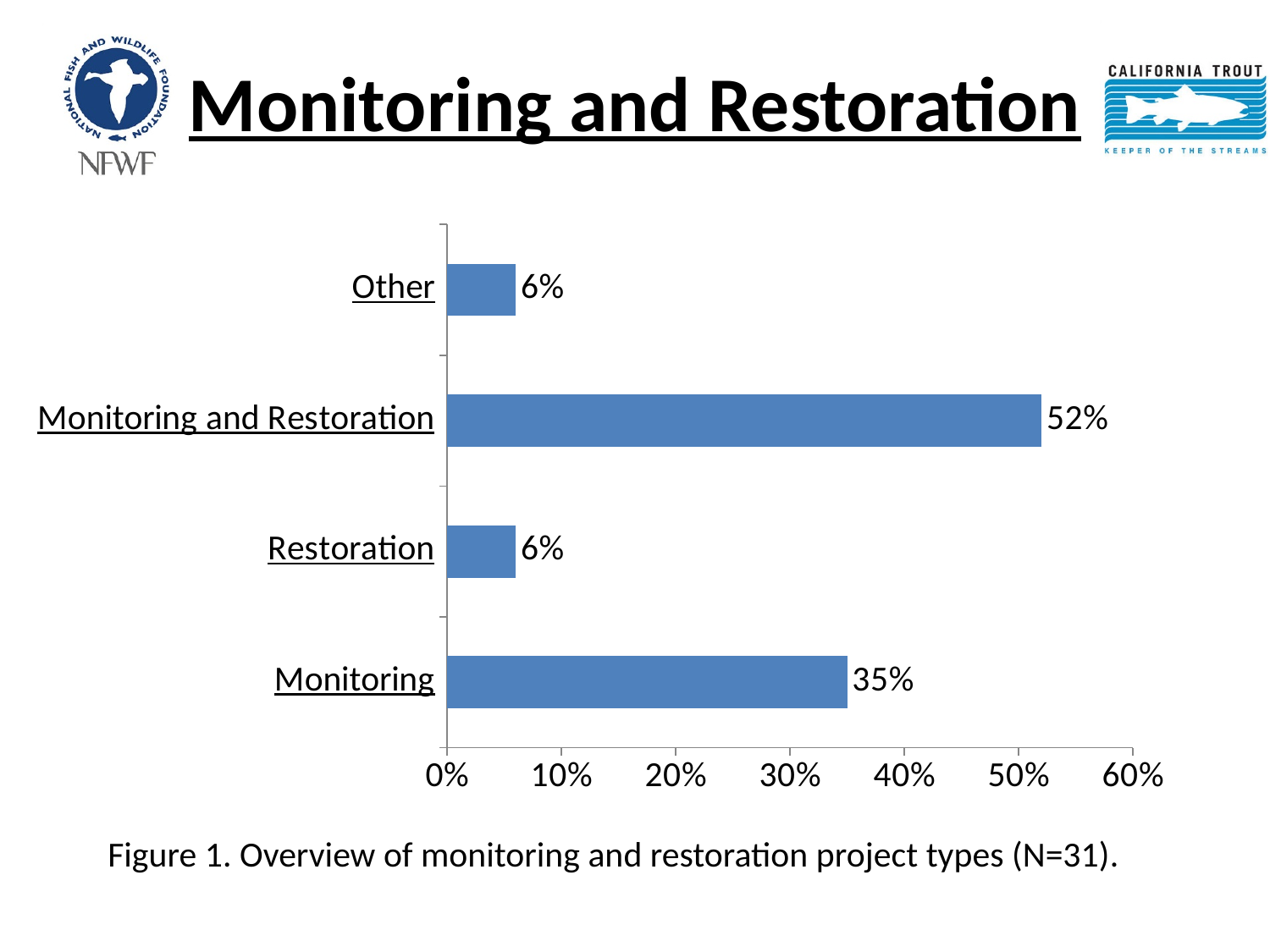
What percentage of projects are Restoration only? 6% How many project type categories are shown in the chart? 4 What percentage of projects are Monitoring only? 35% Which project type has the highest percentage? Monitoring and Restoration What percentage of projects are Monitoring and Restoration? 52% Is the value for Monitoring greater or less than 30%? greater Which is larger, the percentage for Monitoring or for Restoration? Monitoring What percentage of projects fall under Other? 6% What is the difference in percentage between Monitoring and Restoration and Monitoring? 17% What is the difference in percentage between Monitoring and Restoration? 29% What is the sample size (N) given in the figure caption? 31 What kind of chart is shown on the slide? Bar chart